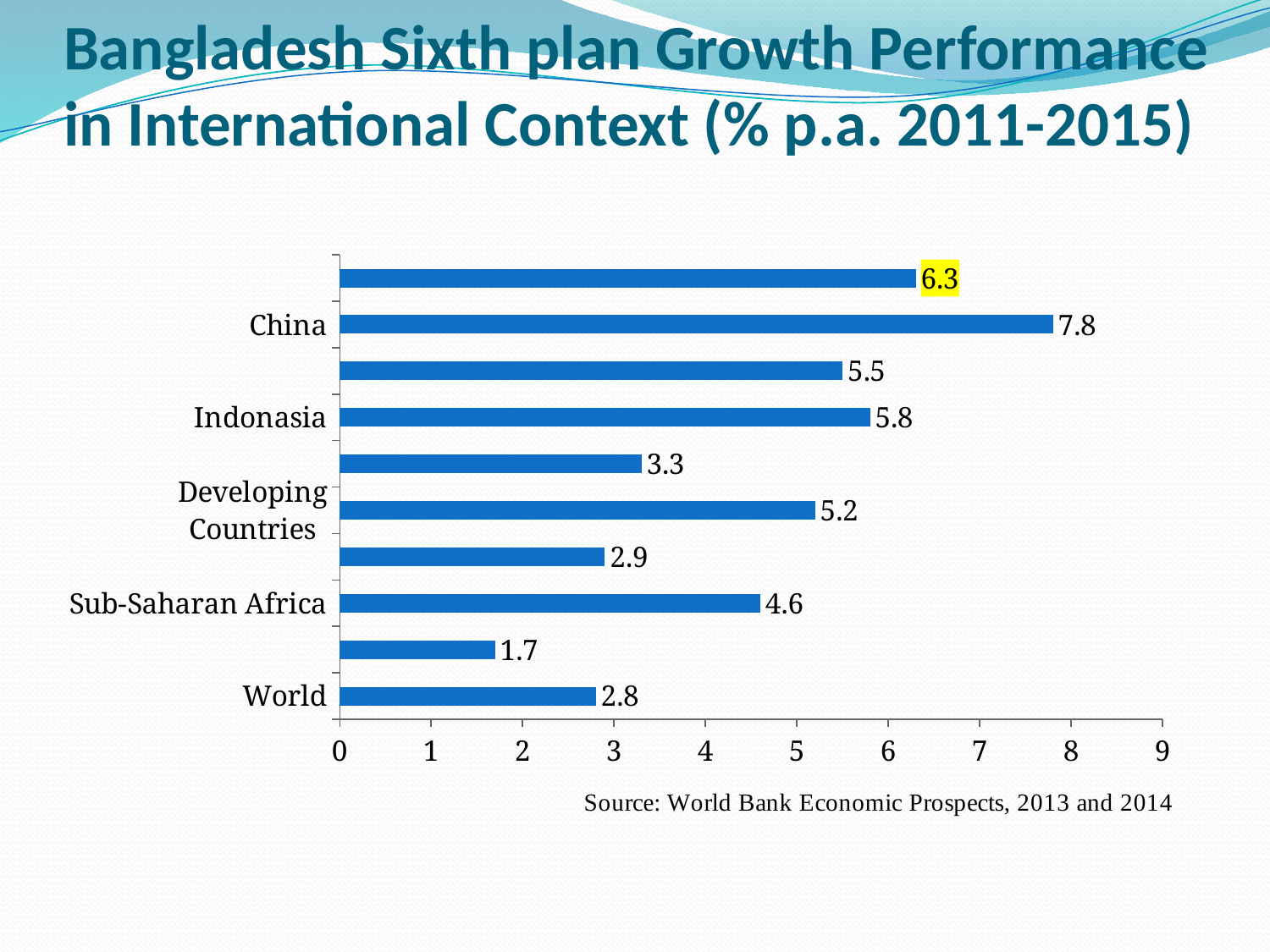
What is the value for Indonasia? 5.8 Which labelled category has the highest value? China What kind of chart is shown on the slide? bar chart What is the smallest value shown on any bar in the chart? 1.7 What is the difference between the values for China and World? 5.0 What is the value for Developing Countries? 5.2 What is the value for China? 7.8 Which is larger, the value for Indonasia or the value for Developing Countries? Indonasia What is the value for Sub-Saharan Africa? 4.6 What is the value shown in the highlighted data label at the top of the chart? 6.3 How many bars are plotted in the chart? 10 What is the value for World? 2.8